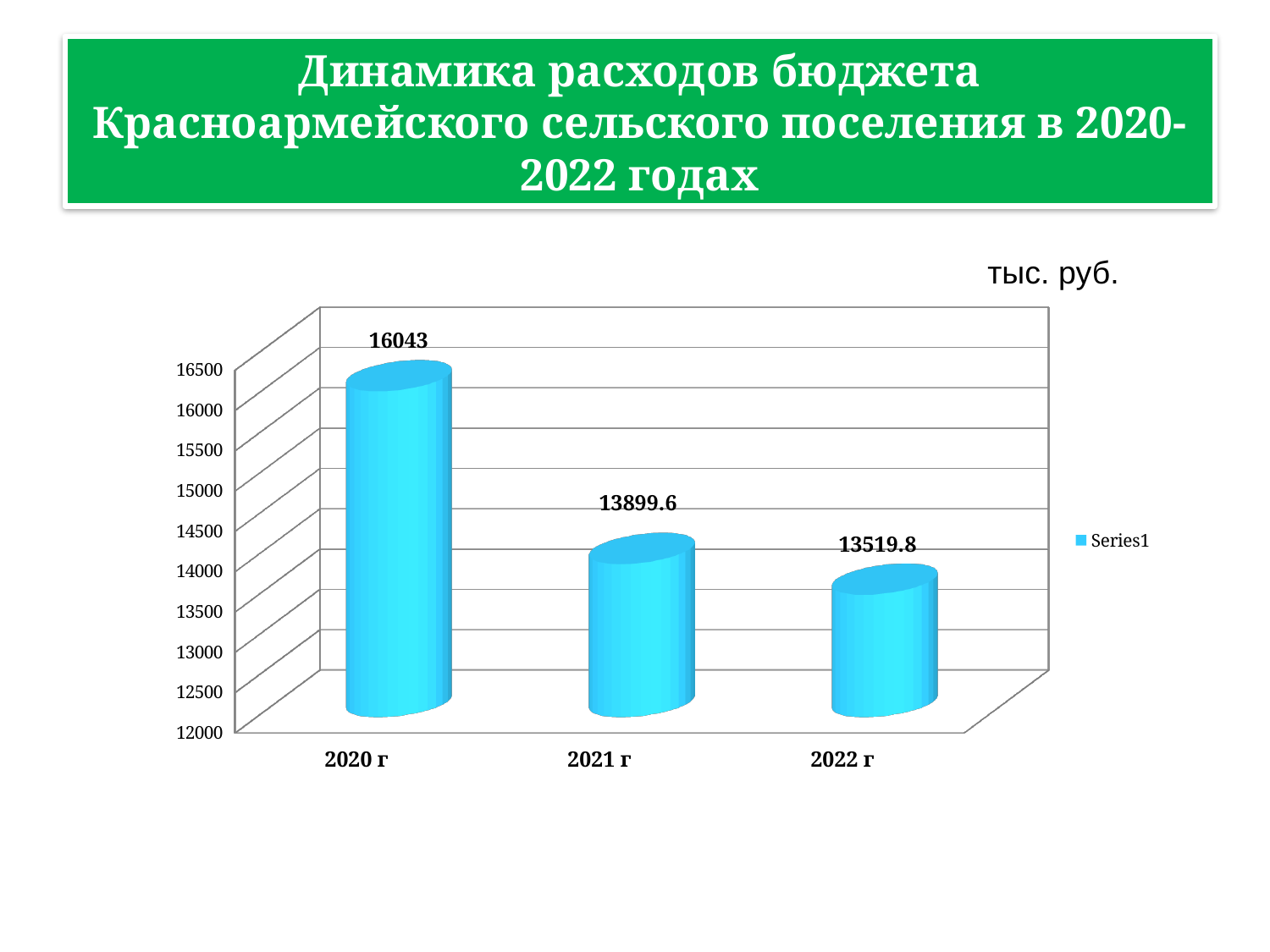
What is the difference between the values for 2020 г and 2021 г? 2143.4 Do the values rise or fall from 2020 г to 2022 г? fall Which year has the highest value? 2020 г Which year has the lowest value? 2022 г What kind of chart is shown on the slide? bar chart How many series does the legend list? 1 What is the value for 2022 г? 13519.8 What is the difference between the values for 2021 г and 2022 г? 379.8 Which is larger, the value for 2021 г or the value for 2022 г? 2021 г How many years are shown on the chart? 3 What is the value for 2021 г? 13899.6 What is the value for 2020 г? 16043